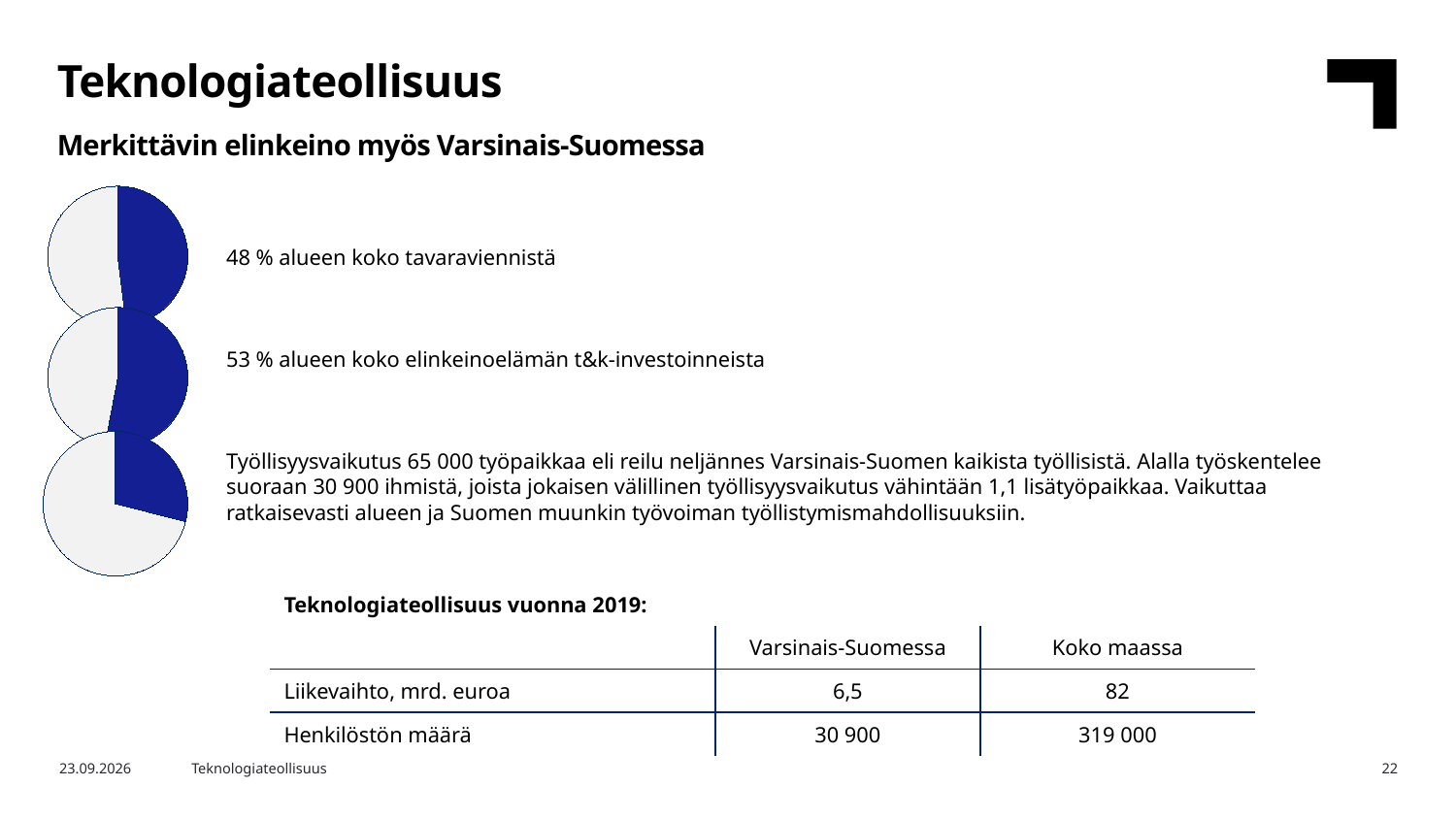
Is the blue slice in the bottom pie chart more or less than half of the pie? Less What does the top pie chart illustrate, according to the text next to it? 48 % alueen koko tavaraviennistä Which of the three pie charts has the smallest blue slice? The bottom one What kind of charts are shown on the left side of the slide? Pie charts What colour is the highlighted slice in each pie chart? Blue Which pie chart has the larger blue slice, the top one or the middle one? The middle one Which of the three pie charts has the largest blue slice? The middle one Is the blue slice in the middle pie chart more or less than half of the pie? More How many pie charts are on the slide? 3 In the middle pie chart, what share does the blue slice represent (alueen koko elinkeinoelämän t&k-investoinneista)? 53 % Which pie chart has the larger blue slice, the top one or the bottom one? The top one In the top pie chart, what share does the blue slice represent (alueen koko tavaraviennistä)? 48 %